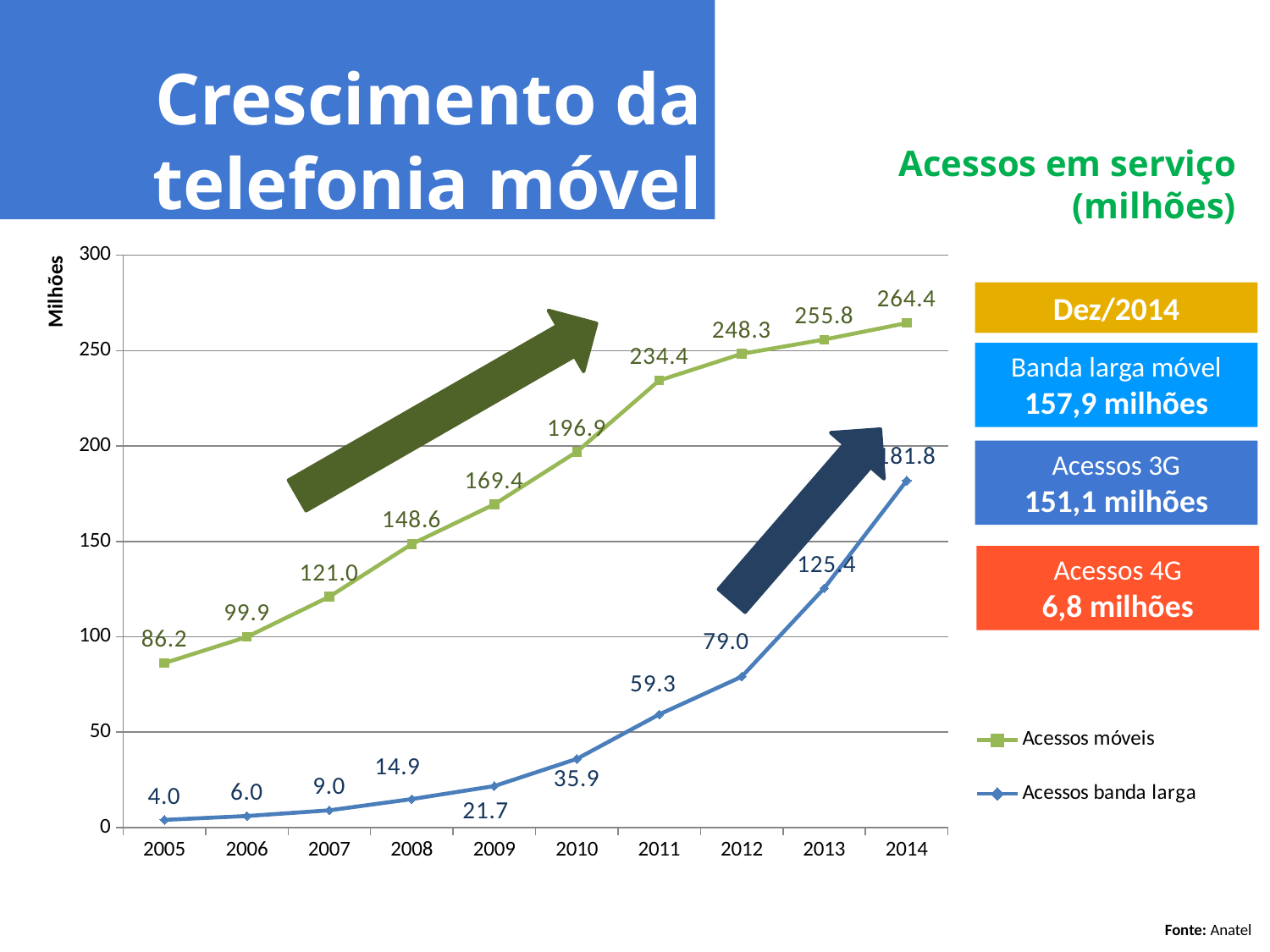
In which year is Acessos móveis highest? 2014 How many series does the legend list? 2 In which year is Acessos banda larga lowest? 2005 What is the value for Acessos banda larga in 2014? 181.8 What is the value for Acessos móveis in 2005? 86.2 What is the value for Acessos banda larga in 2012? 79.0 What is the difference between Acessos móveis and Acessos banda larga in 2014? 82.6 What kind of chart is shown? Line chart How many years are shown on the x axis? 10 Which is larger in 2013: Acessos móveis or Acessos banda larga? Acessos móveis Do the values for Acessos banda larga rise or fall from 2005 to 2014? Rise What is the value for Acessos móveis in 2010? 196.9